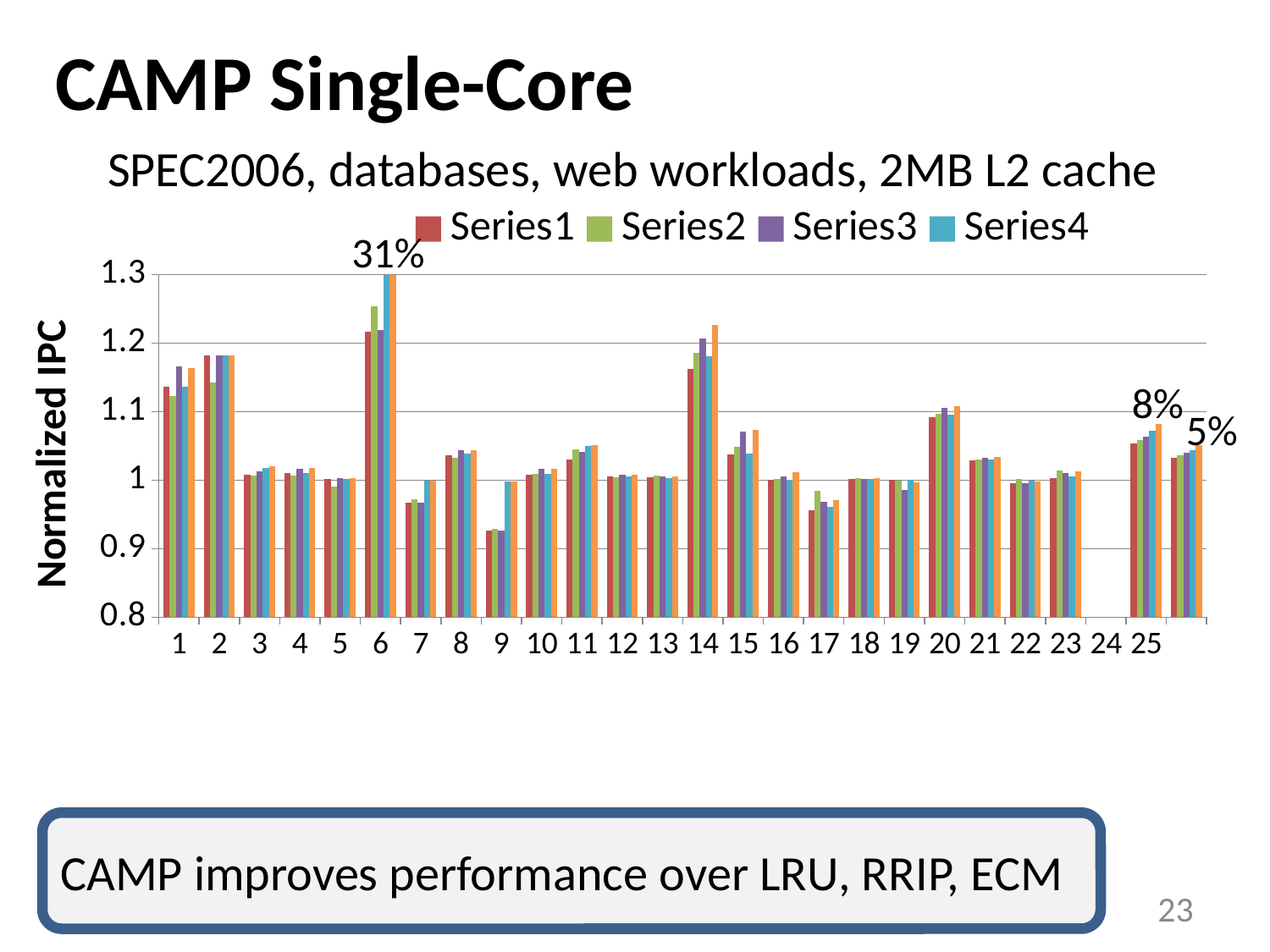
What percentage annotation is printed above the bars for category 6? 31% Which category has the highest bars in the chart? 6 How many categories are labelled on the x axis? 25 Is the Series1 value for category 17 greater or less than 1? less What kind of chart is shown on the slide? bar chart Is the Series1 value for category 14 greater or less than 1.1? greater Which category has the lowest bars in the chart? 9 Is the Series2 value for category 6 greater or less than 1.2? greater What is the title of the y axis? Normalized IPC How many series does the legend list? 4 Which is larger, the Series1 value for category 6 or for category 9? category 6